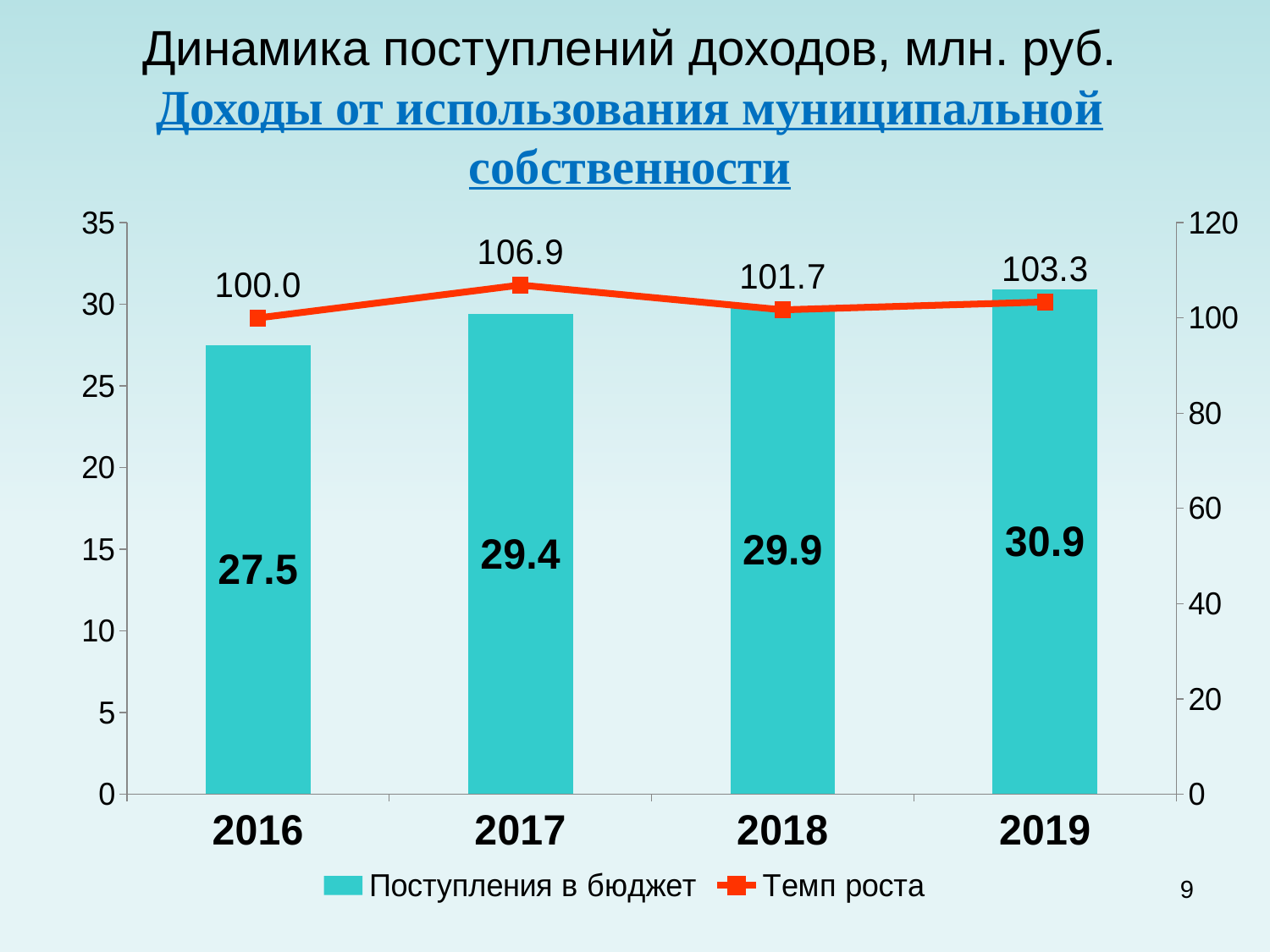
What is the value of Поступления в бюджет for 2017? 29.4 What kind of chart is used for the Поступления в бюджет series? bar chart What is the value of Темп роста for 2018? 101.7 Do the values of Поступления в бюджет rise or fall from 2016 to 2019? rise What is the difference between Поступления в бюджет in 2019 and 2016? 3.4 Which year has the highest value of Поступления в бюджет? 2019 Which year has the lowest value of Темп роста? 2016 Which is larger, Темп роста in 2017 or in 2019? 2017 Is the value of Поступления в бюджет for 2016 greater or less than 25? greater What colour is the Темп роста line? red How many years are shown on the x axis? 4 How many series does the legend list? 2